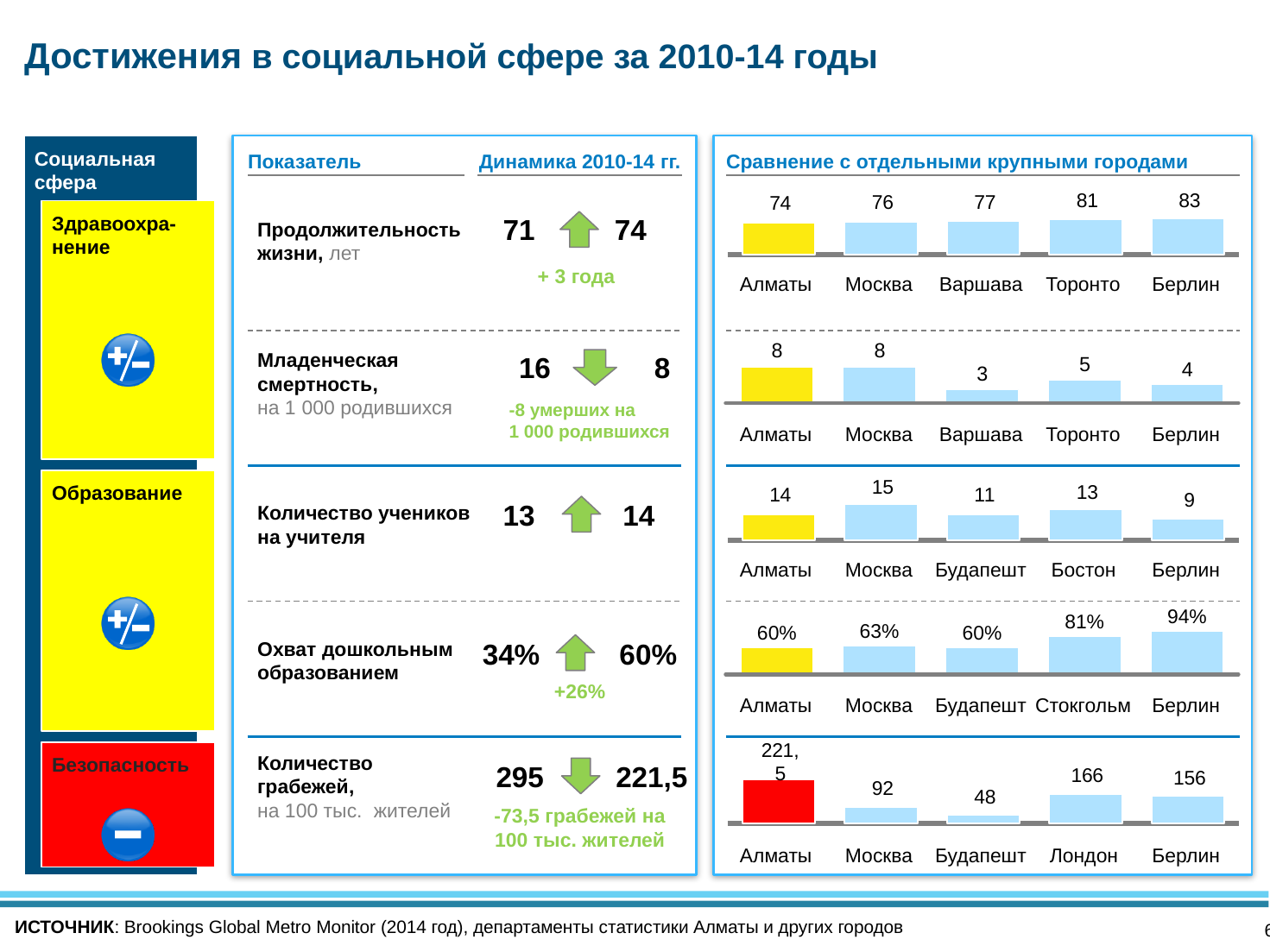
In the fourth chart of the 'Сравнение с отдельными крупными городами' panel (preschool coverage), which is larger, Москва or Берлин? Берлин In the top chart of the 'Сравнение с отдельными крупными городами' panel (life expectancy), which city has the lowest value? Алматы In the second chart of the 'Сравнение с отдельными крупными городами' panel (infant mortality), which city has the lowest value? Варшава In the bottom chart of the 'Сравнение с отдельными крупными городами' panel (robberies per 100 thousand), what is the difference between Лондон and Берлин? 10 In the third chart of the 'Сравнение с отдельными крупными городами' panel (pupils per teacher), which city has the highest value? Москва In the bottom chart of the 'Сравнение с отдельными крупными городами' panel (robberies per 100 thousand), what is the value for Алматы? 221,5 In the second chart of the 'Сравнение с отдельными крупными городами' panel (infant mortality), what is the difference between Алматы and Берлин? 4 What type of chart is used in the 'Сравнение с отдельными крупными городами' panel? Bar chart In the top chart of the 'Сравнение с отдельными крупными городами' panel (life expectancy), what is the value for Берлин? 83 How many cities are shown in the bottom chart of the 'Сравнение с отдельными крупными городами' panel? 5 In the fourth chart of the 'Сравнение с отдельными крупными городами' panel (preschool coverage), what is the value for Стокгольм? 81% In the third chart of the 'Сравнение с отдельными крупными городами' panel (pupils per teacher), what is the value for Бостон? 13